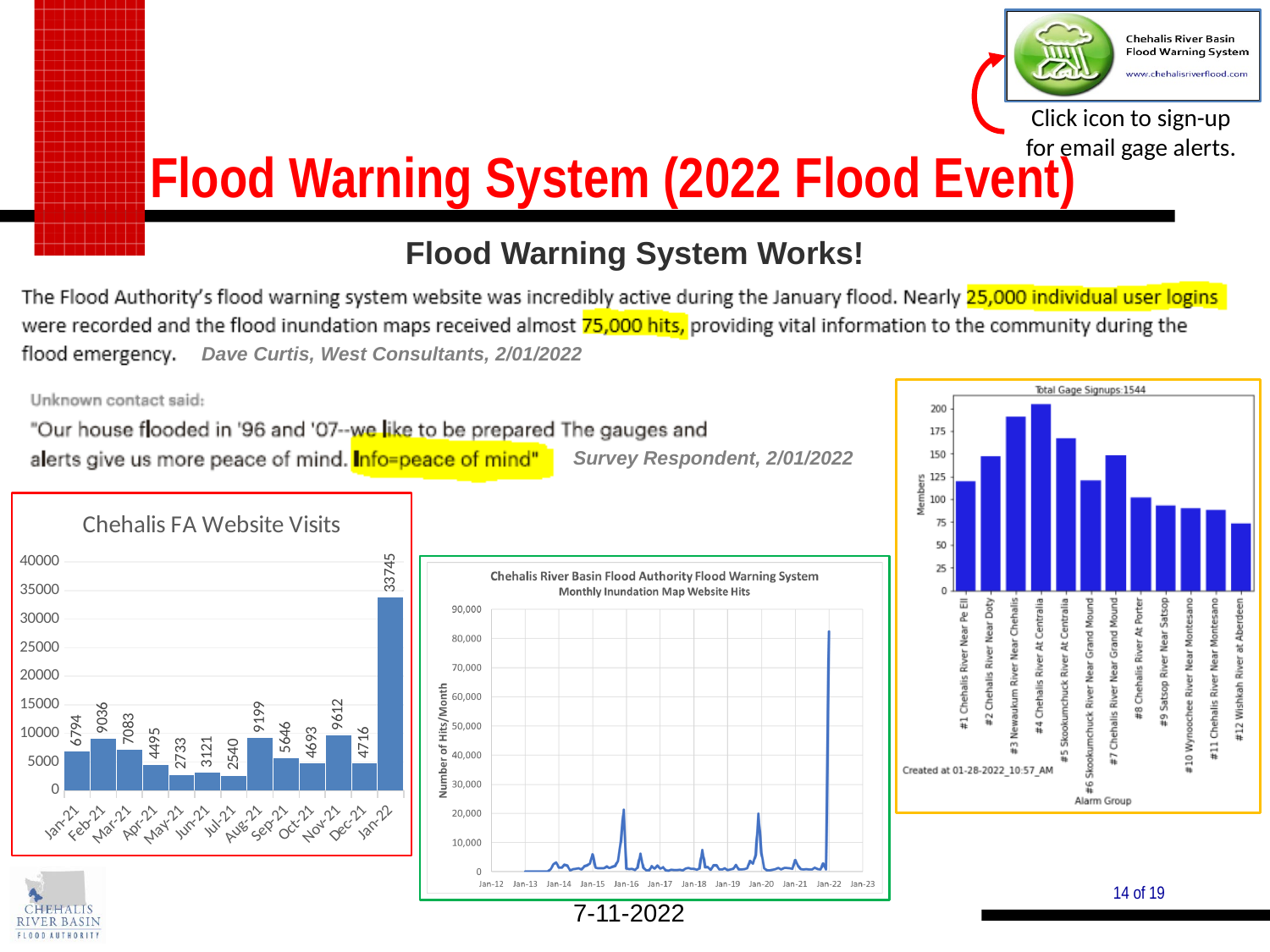
How many months are plotted in the Chehalis FA Website Visits chart? 13 In the Monthly Inundation Map Website Hits chart, is the peak value near Jan-22 greater or less than 70,000? greater In the Chehalis FA Website Visits chart, what is the difference between the Nov-21 and Dec-21 values? 4896 In the Chehalis FA Website Visits chart, what is the value for Jan-22? 33745 What kind of chart is the Chehalis FA Website Visits chart? Bar chart What kind of chart is the Monthly Inundation Map Website Hits chart? Line chart In the Chehalis FA Website Visits chart, what is the value for Aug-21? 9199 In the Chehalis FA Website Visits chart, which is larger, the value for Feb-21 or the value for Mar-21? Feb-21 In the Total Gage Signups chart, is the value for #12 Wishkah River at Aberdeen greater or less than 100? less In the Chehalis FA Website Visits chart, which month has the highest number of visits? Jan-22 In the Chehalis FA Website Visits chart, which month has the lowest number of visits? Jul-21 In the Total Gage Signups chart, which alarm group has the most members? #4 Chehalis River At Centralia